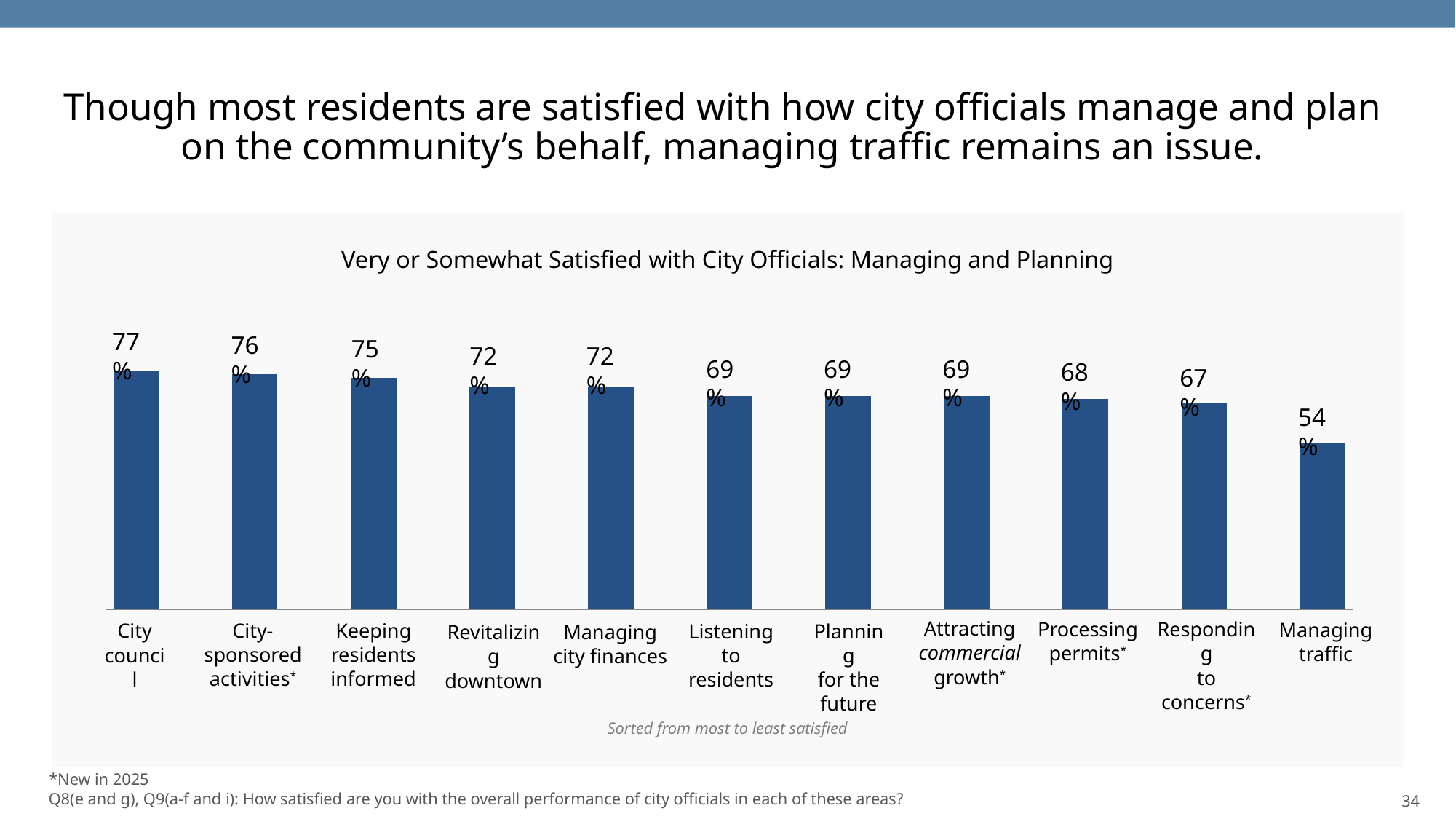
Which is larger, the value for Revitalizing downtown or the value for Listening to residents? Revitalizing downtown What is the title of the chart? Very or Somewhat Satisfied with City Officials: Managing and Planning What is the difference between the values for City council and Managing traffic? 23% Which category has the lowest value? Managing traffic What is the value for City council? 77% What is the value for Managing traffic? 54% What kind of chart is shown on the slide? Bar chart Which category has the highest value? City council What is the difference between the values for City-sponsored activities and Responding to concerns? 9% What is the value for Keeping residents informed? 75% What is the value for Processing permits? 68% How many categories are shown in the chart? 11